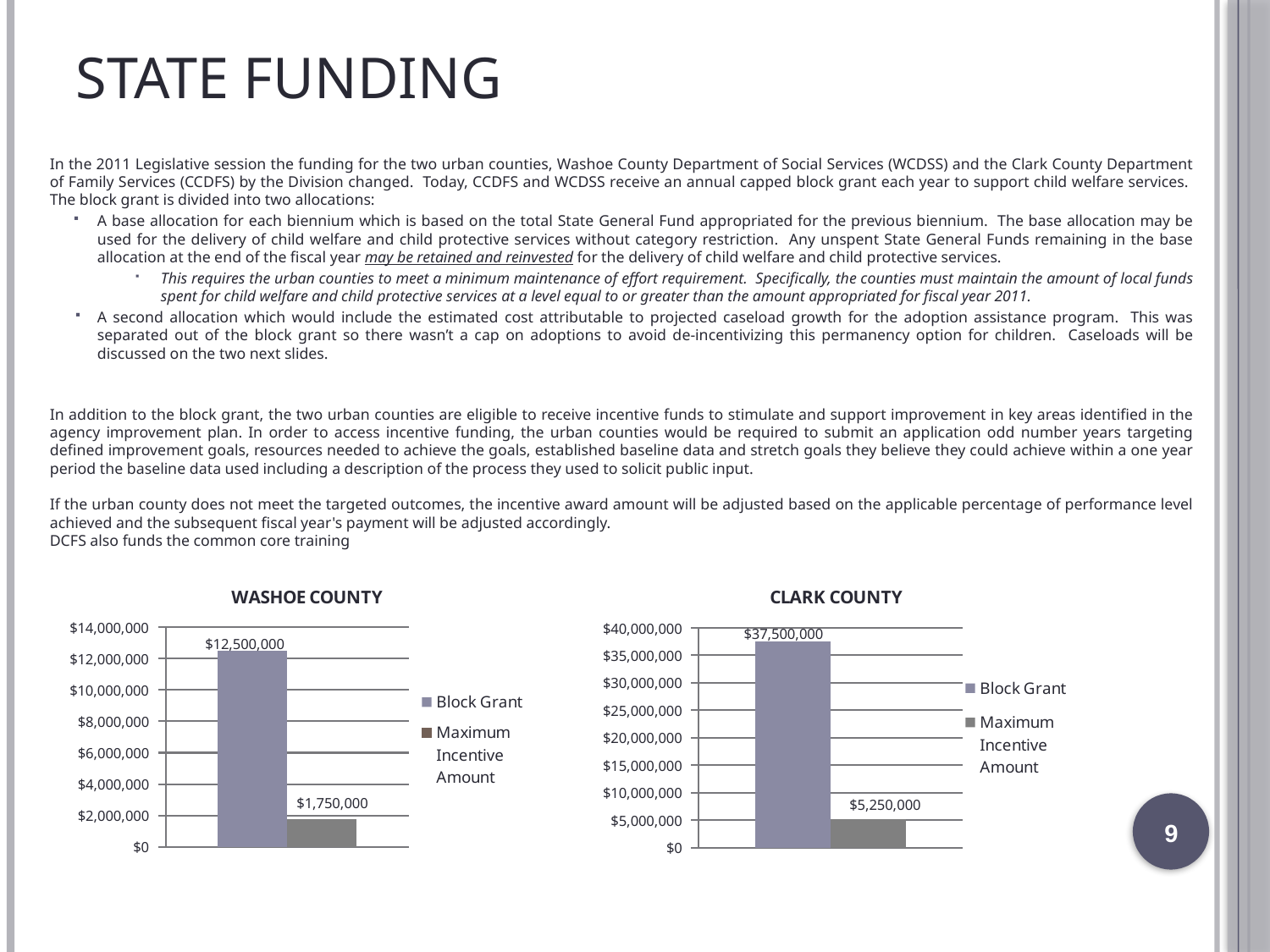
In the Washoe County chart, what is the difference between the Block Grant and the Maximum Incentive Amount? $10,750,000 In the Clark County chart, which series has the higher value, Block Grant or Maximum Incentive Amount? Block Grant In the Washoe County chart, what is the value of the Maximum Incentive Amount bar? $1,750,000 In the Clark County chart, what is the value of the Block Grant bar? $37,500,000 In the Washoe County chart, what is the value of the Block Grant bar? $12,500,000 In the Clark County chart, what is the value of the Maximum Incentive Amount bar? $5,250,000 In the Clark County chart, what is the difference between the Block Grant and the Maximum Incentive Amount? $32,250,000 What kind of chart is the Washoe County chart? Bar chart How many series does the legend of the Clark County chart list? 2 In the Washoe County chart, which series has the lowest value? Maximum Incentive Amount In the Washoe County chart, is the Block Grant value greater or less than $10,000,000? greater What is the title of the chart on the right side of the slide? CLARK COUNTY